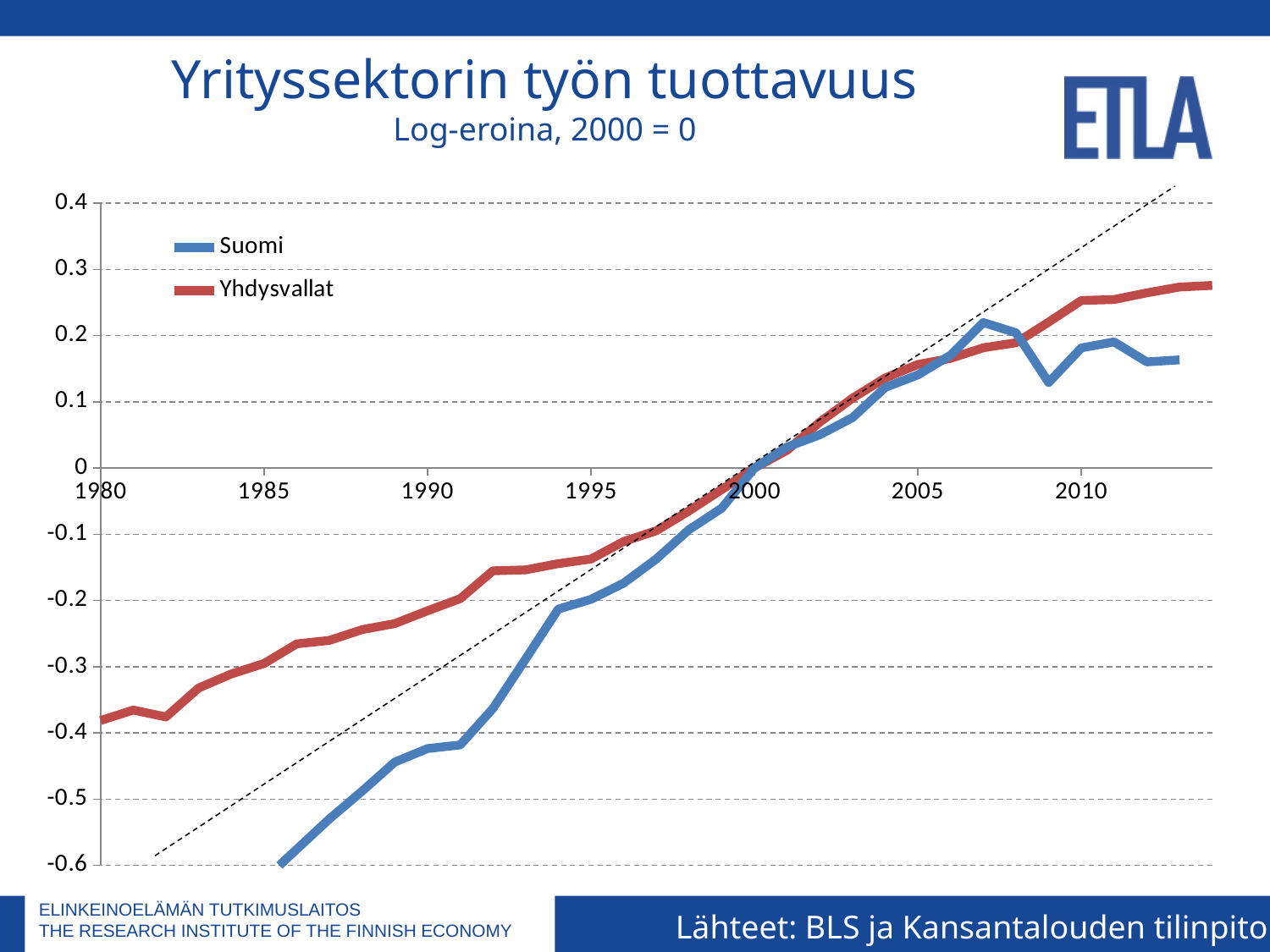
What is the value for Suomi in 2000? 0 Is the value for Suomi in 1990 greater or less than -0.4? less In 2007, which series has the higher value, Suomi or Yhdysvallat? Suomi Which two series are listed in the legend? Suomi and Yhdysvallat Is the value for Yhdysvallat in 2013 greater or less than 0.2? greater Does the Yhdysvallat series rise or fall from 1980 to the end of the period? rise Is the value for Yhdysvallat in 1990 greater or less than -0.3? greater What colour is the Suomi line? blue What kind of chart is shown on the slide? line chart How many series does the legend list? 2 In 1990, which series has the higher value, Suomi or Yhdysvallat? Yhdysvallat